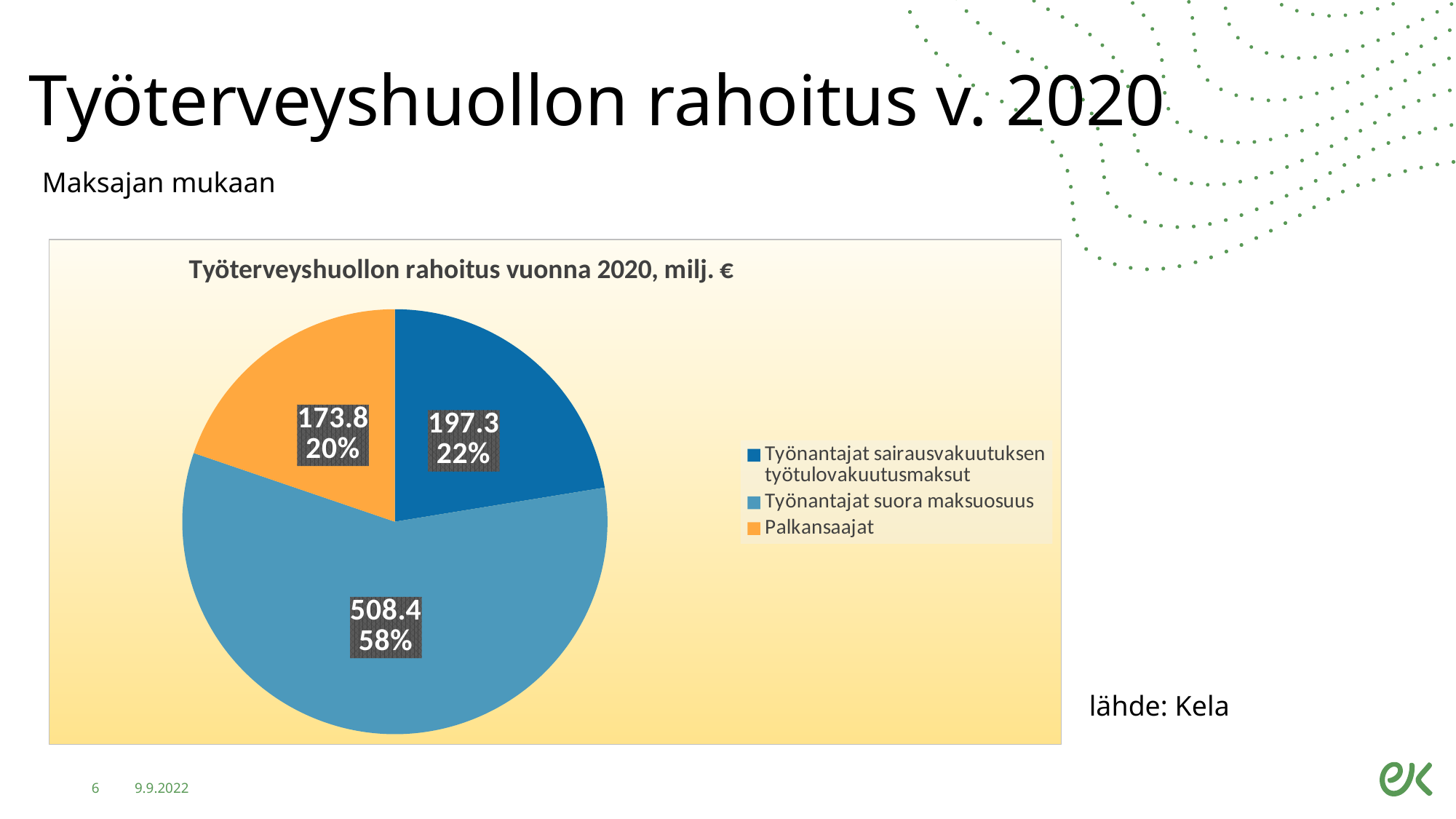
Which category has the largest slice of the pie? Työnantajat suora maksuosuus What is the title of the chart? Työterveyshuollon rahoitus vuonna 2020, milj. € What is the value for Työnantajat suora maksuosuus? 508.4 What kind of chart is shown on the slide? pie chart What is the value for Työnantajat sairausvakuutuksen työtulovakuutusmaksut? 197.3 What is the difference between the values for Työnantajat suora maksuosuus and Palkansaajat? 334.6 Which is larger, the value for Työnantajat sairausvakuutuksen työtulovakuutusmaksut or the value for Palkansaajat? Työnantajat sairausvakuutuksen työtulovakuutusmaksut What share of the pie does Palkansaajat represent? 20% What is the value for Palkansaajat? 173.8 How many categories does the pie chart have? 3 Which category has the smallest slice of the pie? Palkansaajat What share of the pie does Työnantajat suora maksuosuus represent? 58%